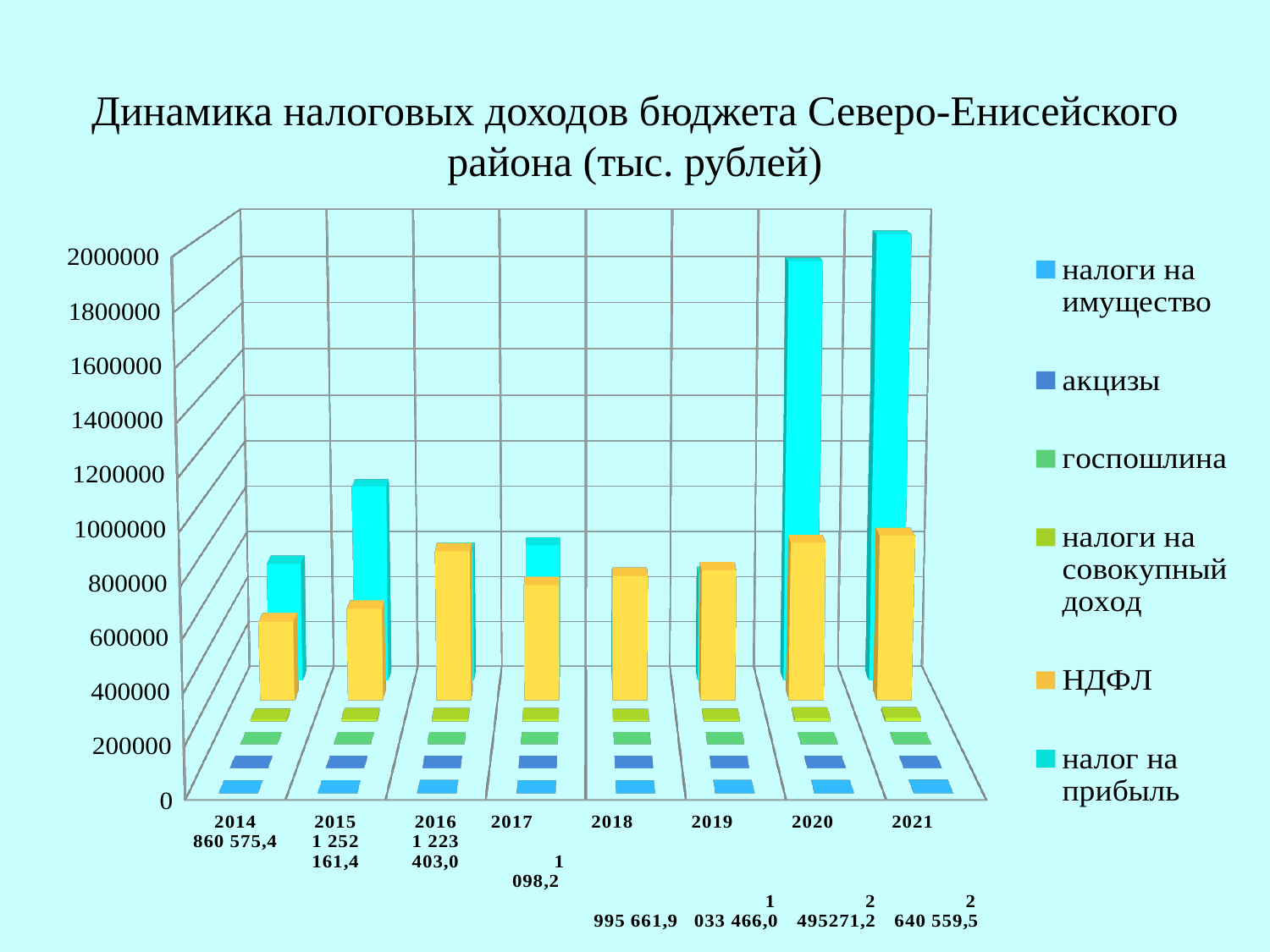
What kind of chart is shown on the slide? bar chart Is the value for налог на прибыль in 2015 greater or less than 800000? greater Which is larger: НДФЛ in 2016 or in 2014? 2016 How many series does the chart legend list? 6 Which series is listed first in the chart legend? налоги на имущество Which is larger: налог на прибыль in 2021 or in 2015? 2021 In which year is the bar for налог на прибыль the tallest? 2021 Is the value for налог на прибыль in 2021 greater or less than 1600000? greater How many years (categories) are shown on the x axis of the chart? 8 What is the title of the chart? Динамика налоговых доходов бюджета Северо-Енисейского района (тыс. рублей) Is the value for НДФЛ in 2014 greater or less than 800000? less Which is larger: налог на прибыль in 2015 or in 2014? 2015